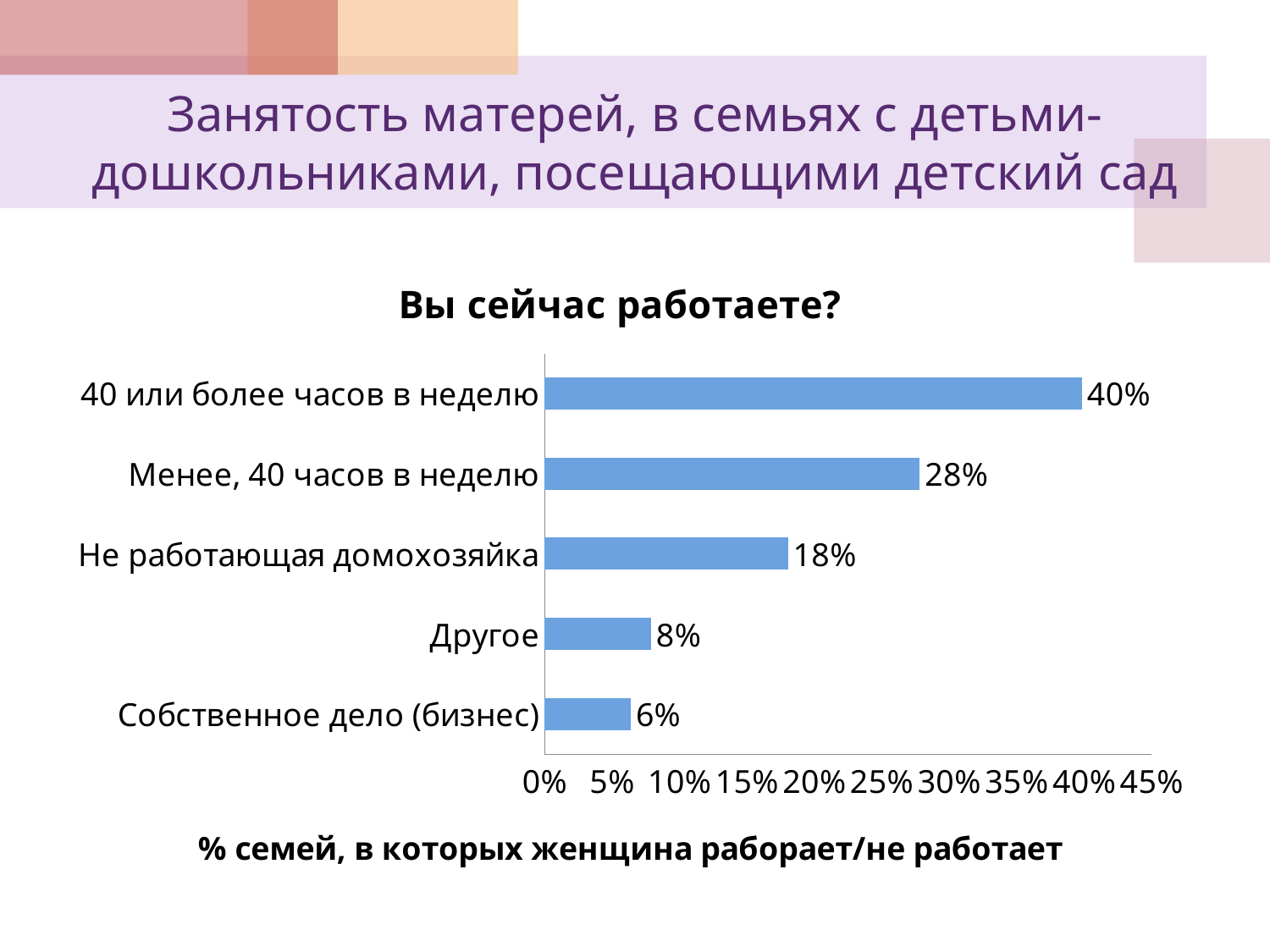
What is the value for "Менее, 40 часов в неделю"? 28% Which category has the highest value? 40 или более часов в неделю How many categories are shown in the chart? 5 What is the value for "Не работающая домохозяйка"? 18% What kind of chart is shown on the slide? bar chart Which is larger: the value for "Другое" or the value for "Собственное дело (бизнес)"? Другое What is the title of the chart? Вы сейчас работаете? What is the value for "Собственное дело (бизнес)"? 6% Is the value for "Не работающая домохозяйка" greater or less than 20%? less What is the difference between the values for "40 или более часов в неделю" and "Менее, 40 часов в неделю"? 12% Which category has the lowest value? Собственное дело (бизнес) What is the value for "40 или более часов в неделю"? 40%